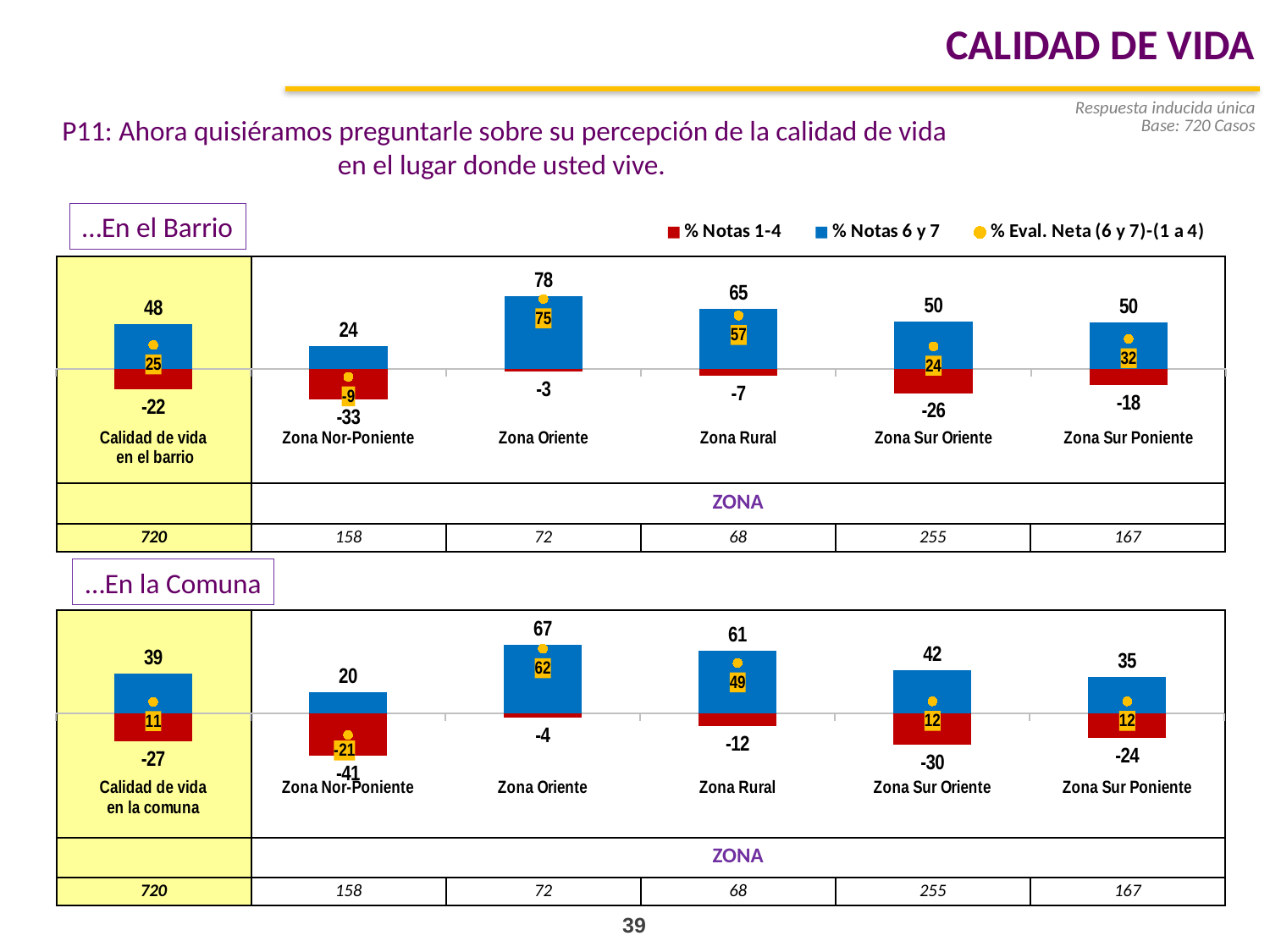
In the '...En la Comuna' chart, what is the % Notas 6 y 7 value for Zona Sur Poniente? 35 In the '...En el Barrio' chart, what is the difference between the % Notas 6 y 7 values for Zona Oriente and Zona Rural? 13 In the '...En el Barrio' chart, what is the % Notas 6 y 7 value for Zona Oriente? 78 In the '...En el Barrio' chart, which zone has the highest % Notas 6 y 7 value? Zona Oriente In the '...En el Barrio' chart, what is the % Notas 1-4 value for Zona Nor-Poniente? -33 In the '...En el Barrio' chart, which zone has the lowest % Eval. Neta value? Zona Nor-Poniente How many series does the legend list for the '...En el Barrio' chart? 3 In the '...En la Comuna' chart, what is the % Notas 1-4 value for Zona Sur Oriente? -30 In the '...En la Comuna' chart, which is larger, the % Notas 6 y 7 value for Zona Rural or for Zona Sur Oriente? Zona Rural In the '...En la Comuna' chart, which zone has the highest % Eval. Neta value? Zona Oriente In the '...En la Comuna' chart, what is the % Eval. Neta value for Calidad de vida en la comuna? 11 In the '...En el Barrio' chart, what is the % Eval. Neta value for Zona Rural? 57